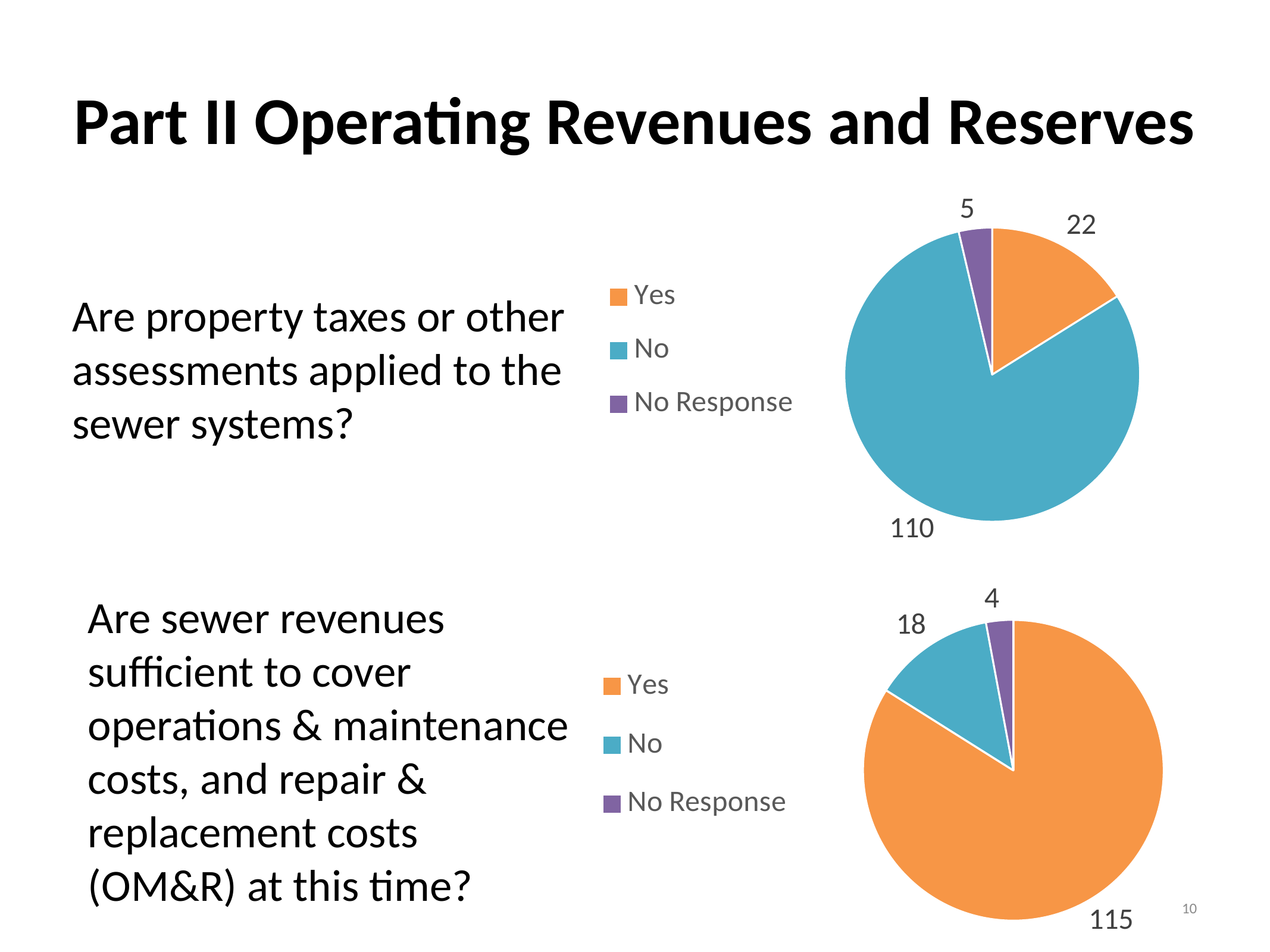
How many categories does the legend of the top pie chart list? 3 In the bottom pie chart (sewer revenues sufficient to cover OM&R), what is the difference between the Yes and No values? 97 In the top pie chart (property taxes or other assessments), what is the value for No? 110 In the bottom pie chart (sewer revenues sufficient to cover OM&R), what is the value for No? 18 In the top pie chart (property taxes or other assessments), what is the value for No Response? 5 In the top pie chart (property taxes or other assessments), what is the difference between the No and Yes values? 88 In the bottom pie chart (sewer revenues sufficient to cover OM&R), what is the value for Yes? 115 In the top pie chart (property taxes or other assessments), what is the value for Yes? 22 In the top pie chart (property taxes or other assessments), which category has the largest slice? No In the bottom pie chart (sewer revenues sufficient to cover OM&R), which is larger, Yes or No? Yes What type of chart is used for the bottom chart (sewer revenues sufficient to cover OM&R)? Pie chart In the bottom pie chart (sewer revenues sufficient to cover OM&R), which category has the smallest slice? No Response